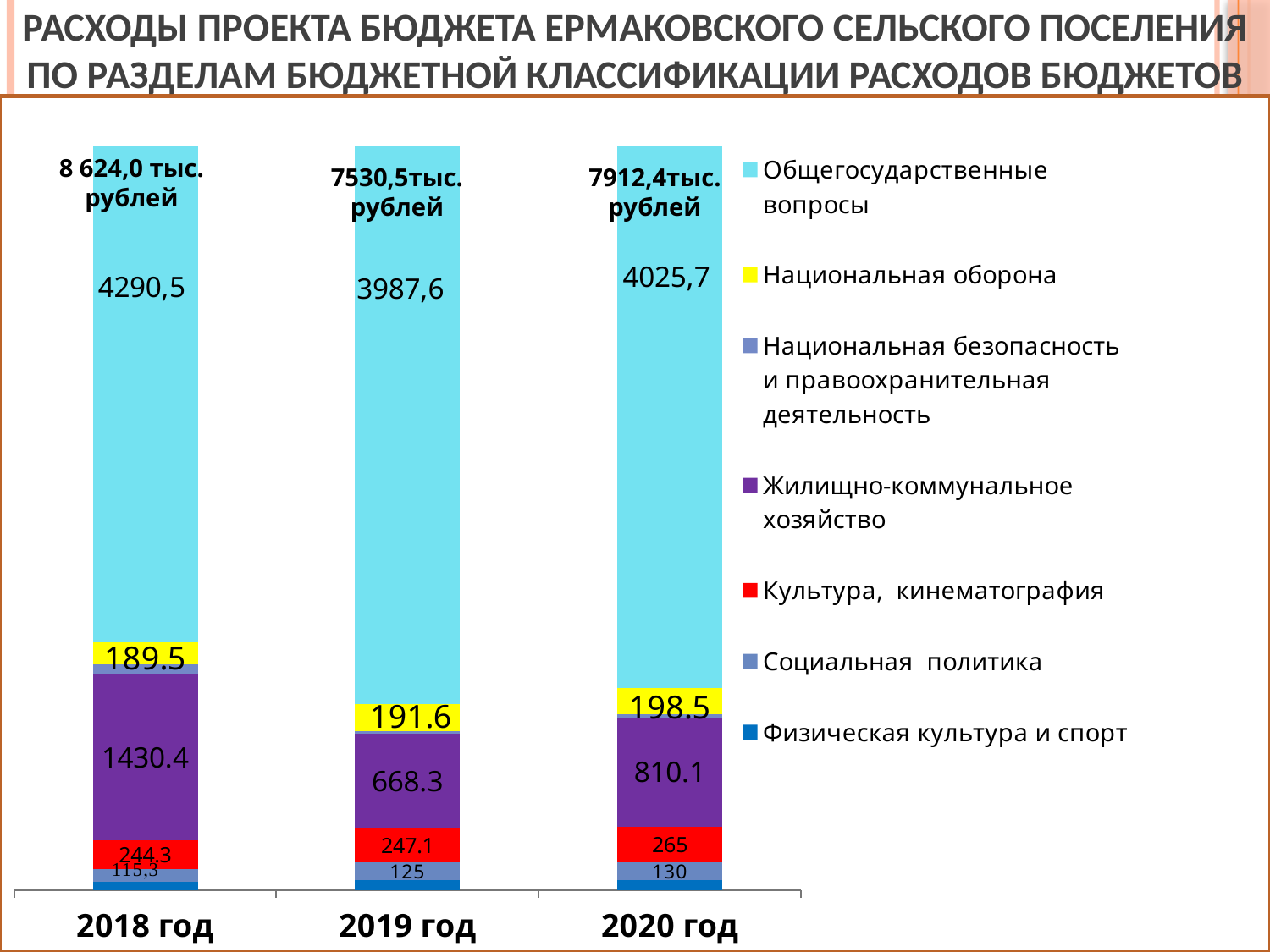
Which is larger: Общегосударственные вопросы in 2018 год or in 2020 год? 2018 год Do the values for Социальная политика rise or fall from 2018 год to 2020 год? rise What is the difference between the Жилищно-коммунальное хозяйство values for 2020 год and 2019 год? 141.8 What is the value for Общегосударственные вопросы in 2019 год? 3987,6 What is the total of the stacked bar for 2020 год? 7912,4 тыс. рублей What is the value for Национальная оборона in 2019 год? 191.6 What kind of chart is shown on the slide? stacked bar chart Which year has the highest total expenditure? 2018 год How many years (categories) are shown on the x axis? 3 What is the value for Жилищно-коммунальное хозяйство in 2018 год? 1430.4 What is the value for Культура, кинематография in 2020 год? 265 How many series does the legend list? 7